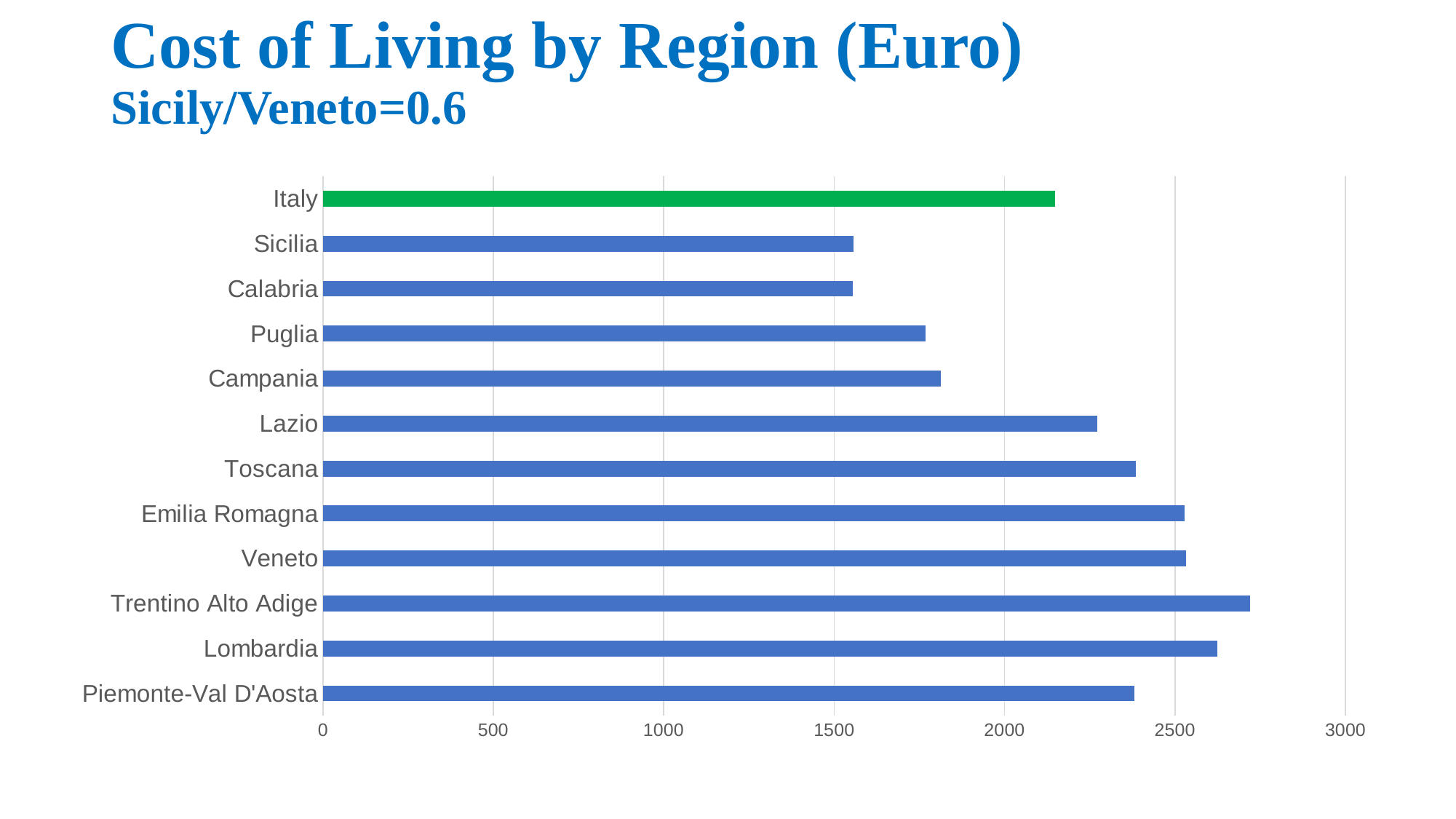
Is the value for Lombardia greater or less than 2500? greater Is the value for Puglia greater or less than 2000? less Is the value for Sicilia greater or less than 1500? greater Which has a higher cost of living, Lazio or Campania? Lazio Which bar is coloured green rather than blue? Italy What is the title of the chart? Cost of Living by Region (Euro) How many regions (categories) are plotted on the chart? 12 Which region has the highest cost of living on the chart? Trentino Alto Adige What kind of chart is shown on the slide? bar chart Which has a higher cost of living, Lombardia or Veneto? Lombardia